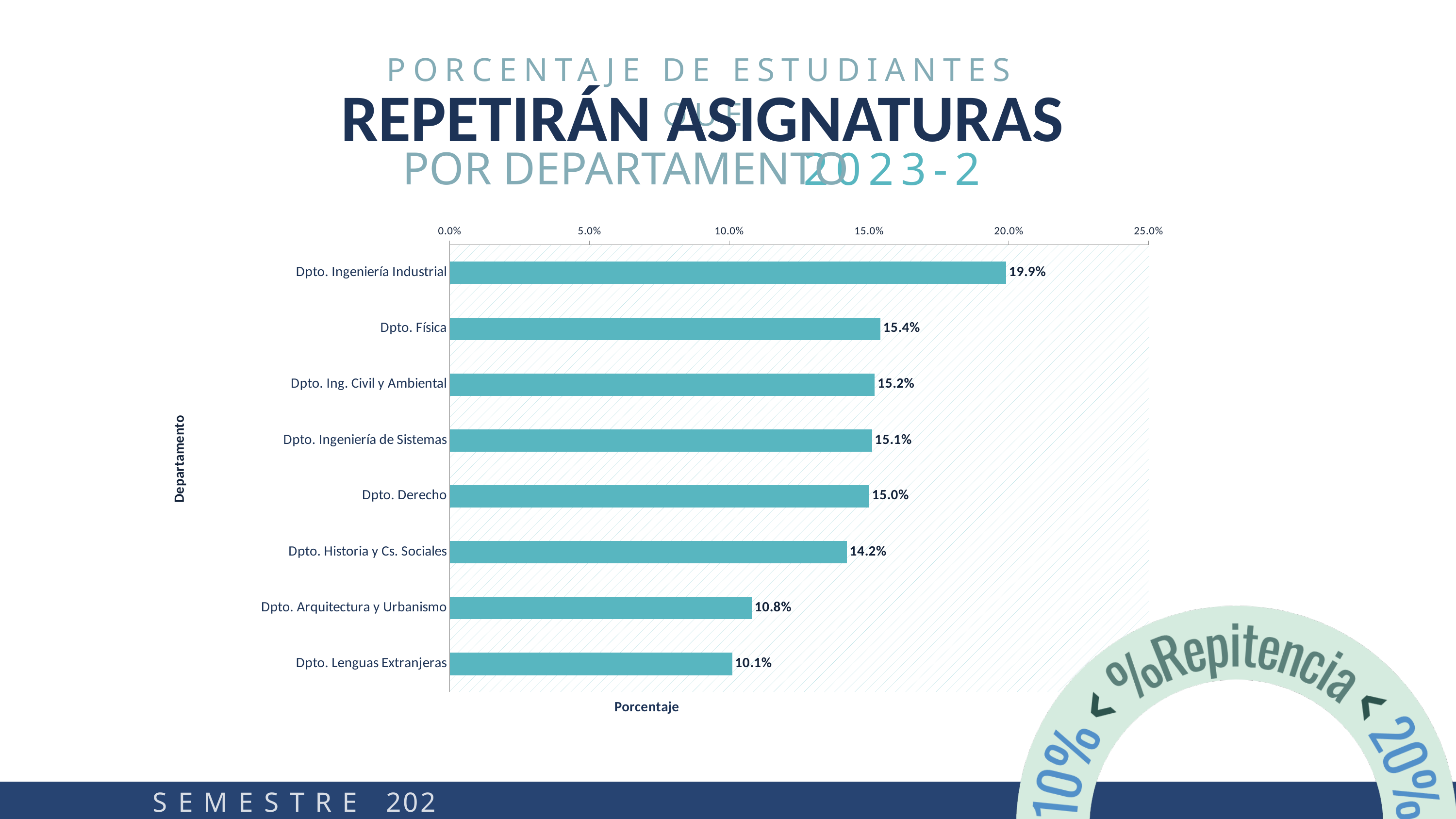
What is the difference between Dpto. Ingeniería Industrial and Dpto. Física? 4.5% Which department has the lowest percentage? Dpto. Lenguas Extranjeras What is the value for Dpto. Historia y Cs. Sociales? 14.2% How many departments are shown in the chart? 8 What is the label of the horizontal axis? Porcentaje What is the value for Dpto. Ingeniería Industrial? 19.9% Which department has the highest percentage? Dpto. Ingeniería Industrial What is the value for Dpto. Arquitectura y Urbanismo? 10.8% Is the value for Dpto. Ingeniería Industrial greater or less than 15.0%? greater Which is larger, the value for Dpto. Derecho or the value for Dpto. Arquitectura y Urbanismo? Dpto. Derecho What kind of chart is shown on the slide? bar chart What is the value for Dpto. Lenguas Extranjeras? 10.1%